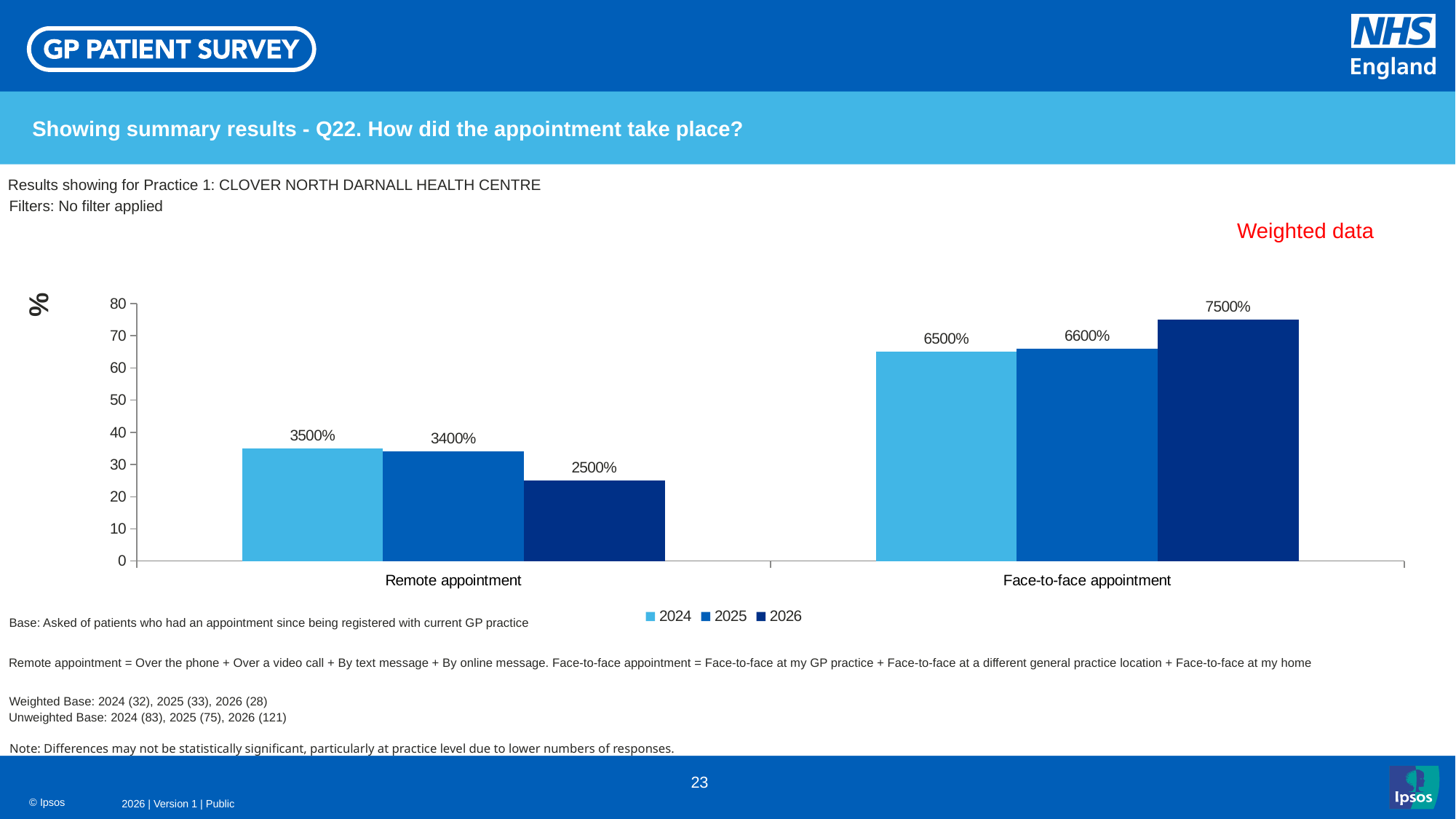
What is the data label for 2024 on the Remote appointment bar? 3500% How many categories are shown on the x axis? 2 How many series does the legend list? 3 Which year has the lowest value for Remote appointment? 2026 Which is larger: the 2025 value for Remote appointment or the 2025 value for Face-to-face appointment? Face-to-face appointment What is the data label for 2025 on the Remote appointment bar? 3400% Is the 2026 bar for Remote appointment above or below the 30 mark on the axis? below What is the data label for 2026 on the Face-to-face appointment bar? 7500% Do the Remote appointment values rise or fall from 2024 to 2026? fall Which year has the highest value for Face-to-face appointment? 2026 What kind of chart is shown on the slide? Bar chart What is the data label for 2024 on the Face-to-face appointment bar? 6500%